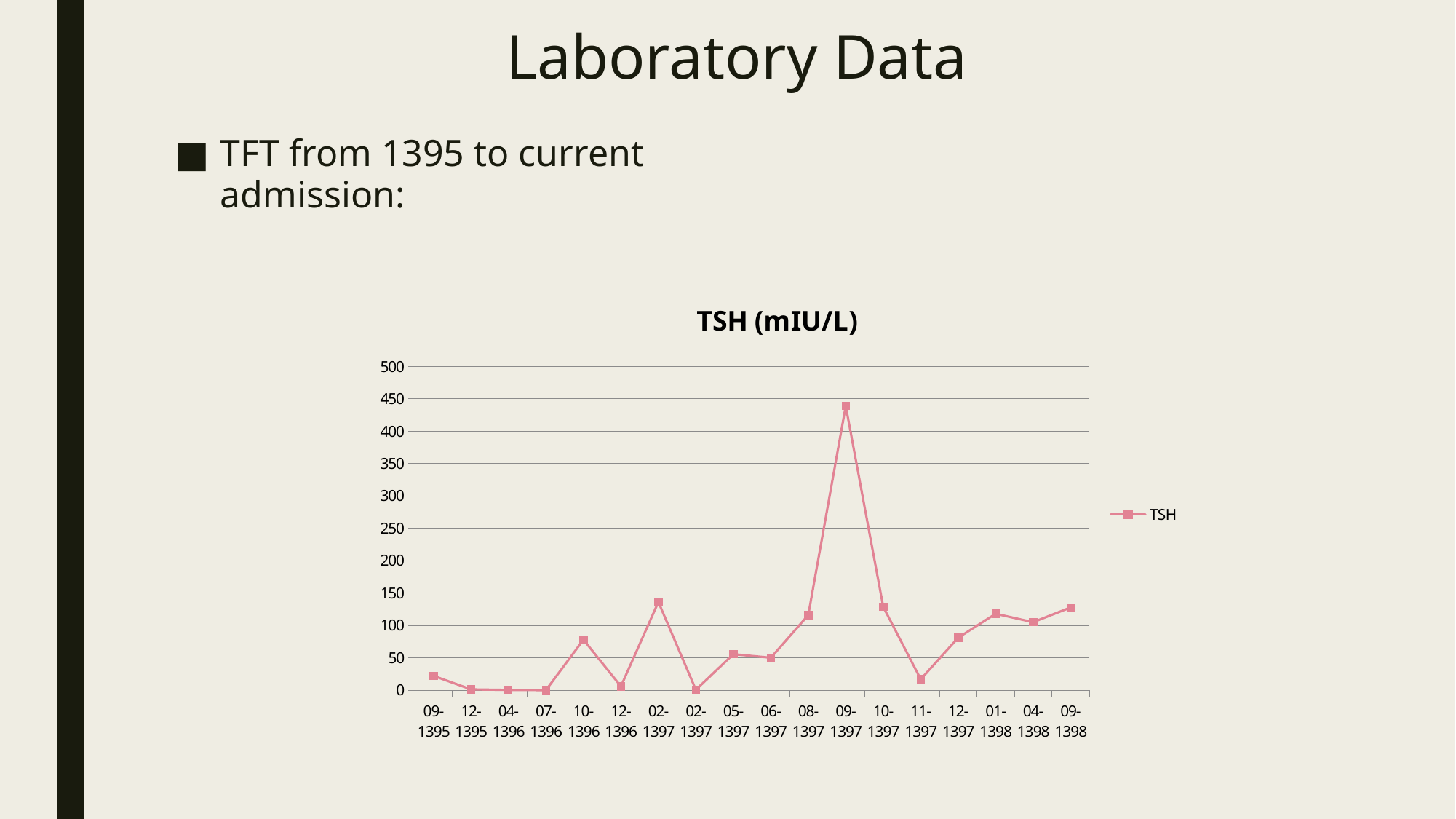
Is the TSH value for 11-1397 greater or less than 50? less Is the TSH value for 09-1398 greater or less than 100? greater What kind of chart is shown on the slide? line chart Is the TSH value for 09-1397 greater or less than 400? greater What is the title of the chart? TSH (mIU/L) How many series does the legend list? 1 How many data points are plotted on the x axis? 18 Which has the larger TSH value, 10-1396 or 12-1396? 10-1396 Does the TSH value rise or fall from 09-1397 to 11-1397? fall Which date has the highest TSH value? 09-1397 Which has the larger TSH value, 09-1397 or 10-1397? 09-1397